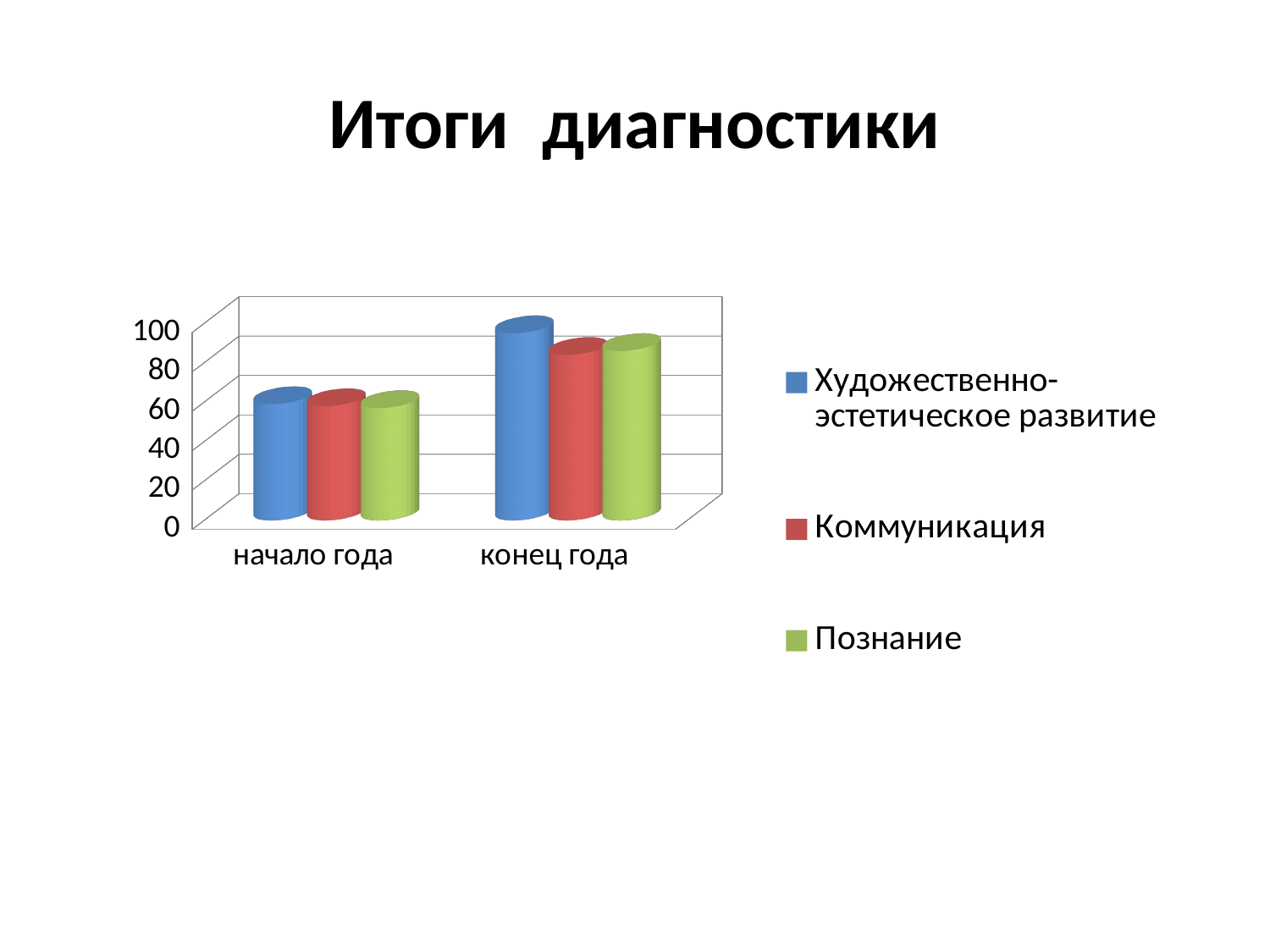
Is the value for Коммуникация at конец года greater or less than 60? greater Which colour represents the series Познание? green Is the value for Художественно-эстетическое развитие at конец года greater or less than 80? greater What is the title of the slide with the chart? Итоги диагностики How many categories are shown on the x axis? 2 Is the value for Познание at начало года greater or less than 40? greater How many series does the legend list? 3 Which series has the highest value at конец года? Художественно-эстетическое развитие What kind of chart is shown on the slide? bar chart For Познание, which is larger: the value at начало года or at конец года? конец года Do the values rise or fall from начало года to конец года? rise